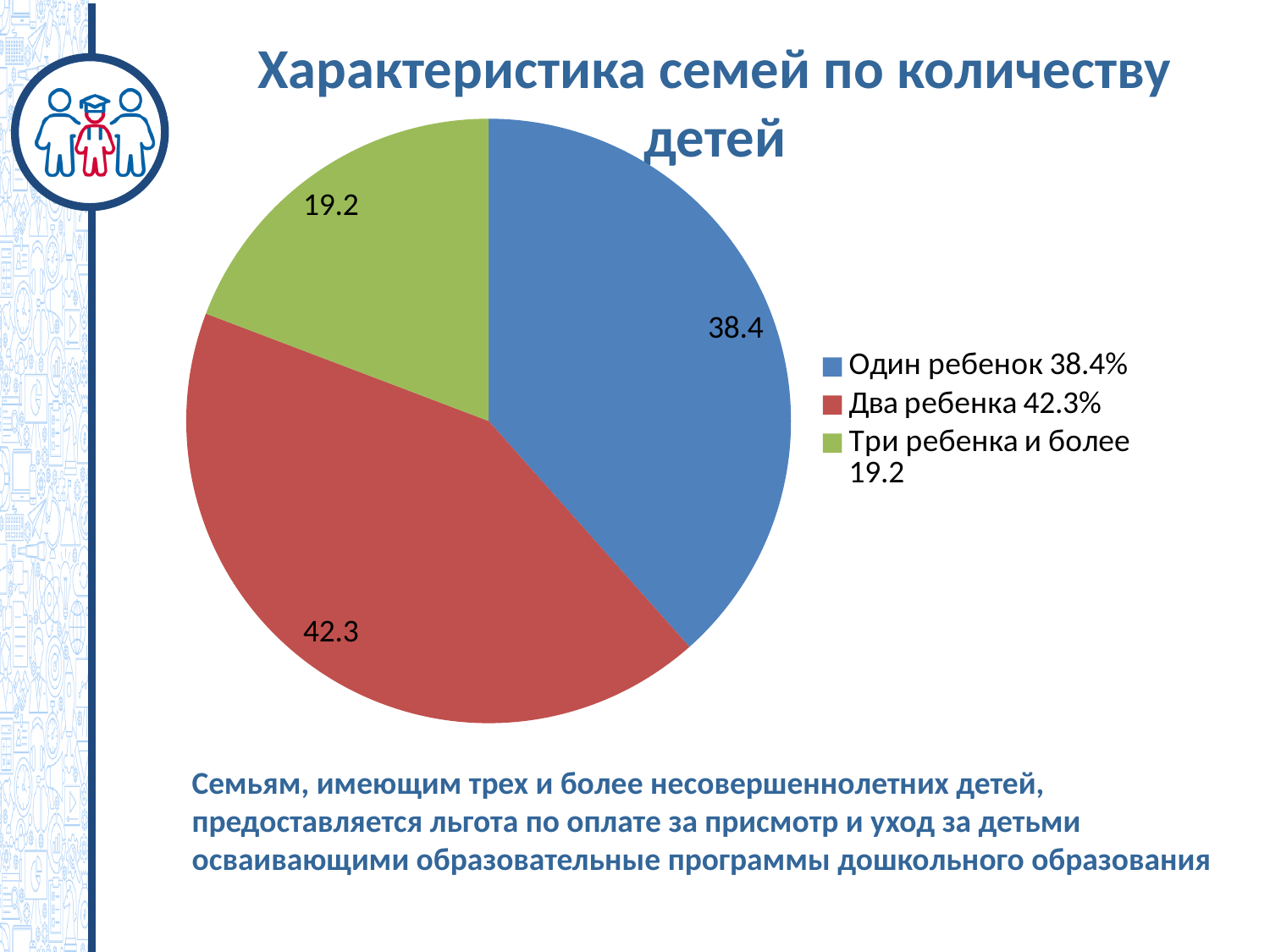
What is the value shown for the 'Один ребенок' slice? 38.4 What is the difference between the values for 'Один ребенок' and 'Три ребенка и более'? 19.2 Which is larger: the slice for 'Один ребенок' or the slice for 'Три ребенка и более'? Один ребенок Which category has the smallest slice of the pie? Три ребенка и более What type of chart is shown on the slide? Pie chart What colour is the slice for 'Три ребенка и более'? Green What is the value shown for the 'Два ребенка' slice? 42.3 Which category has the largest slice of the pie? Два ребенка What is the title of the chart? Характеристика семей по количеству детей How many slices does the pie chart have? 3 What is the value shown for the 'Три ребенка и более' slice? 19.2 What is the difference between the values for 'Два ребенка' and 'Один ребенок'? 3.9